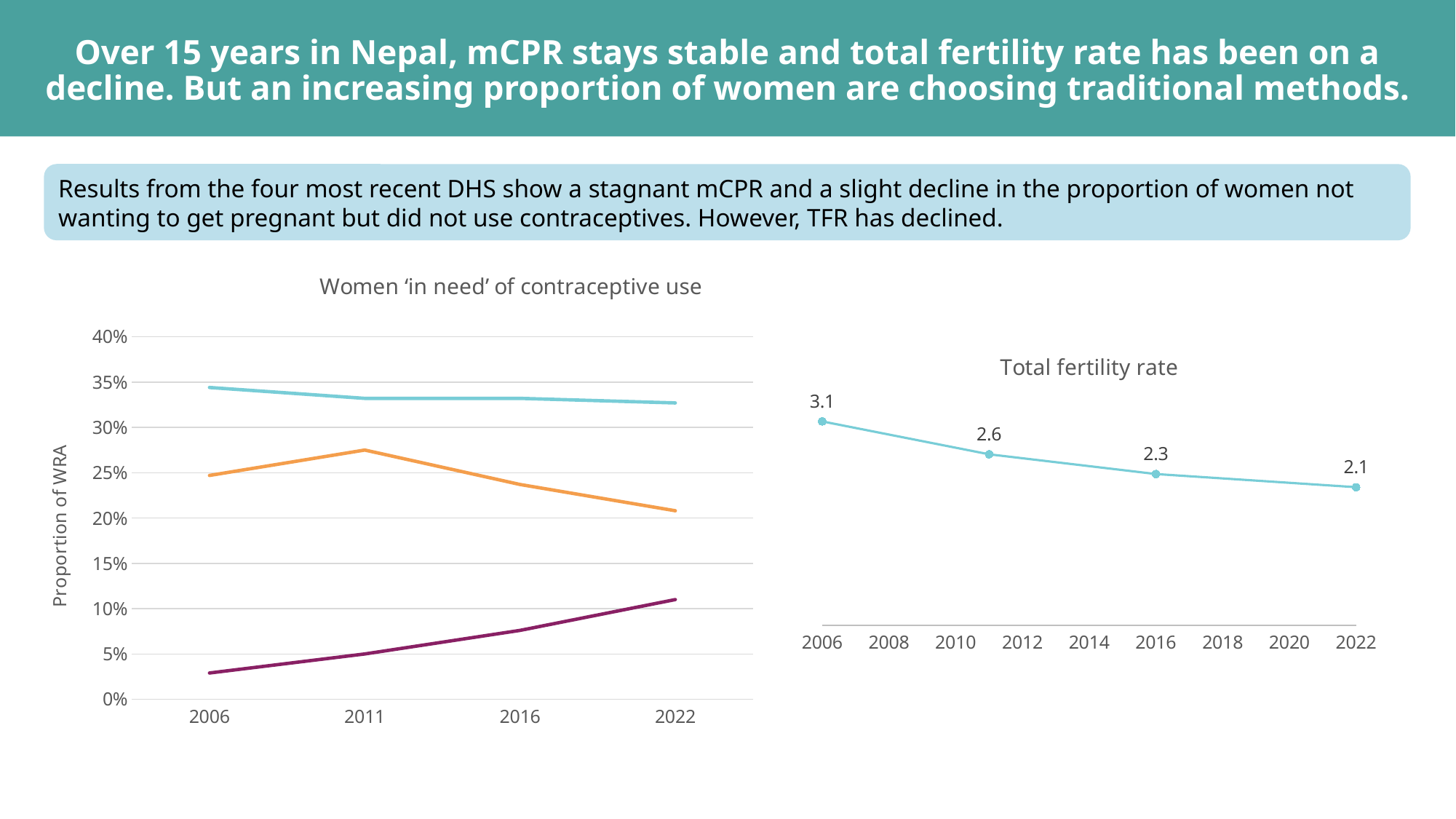
In the Total fertility rate chart, what is the value for 2022? 2.1 In the Women 'in need' of contraceptive use chart, is the value of the purple line in 2006 greater or less than 5%? less In the Women 'in need' of contraceptive use chart, is the value of the orange line in 2011 greater or less than 25%? greater In the Total fertility rate chart, which year has the highest value? 2006 In the Total fertility rate chart, what is the value for 2016? 2.3 In the Total fertility rate chart, how many data points are plotted? 4 In the Total fertility rate chart, do the values rise or fall from 2006 to 2022? fall In the Women 'in need' of contraceptive use chart, does the purple line rise or fall from 2006 to 2022? rise In the Total fertility rate chart, what is the value for 2006? 3.1 In the Total fertility rate chart, what is the difference between the 2006 and 2022 values? 1.0 In the Total fertility rate chart, which year has the lowest value? 2022 What kind of chart is the Women 'in need' of contraceptive use chart? line chart